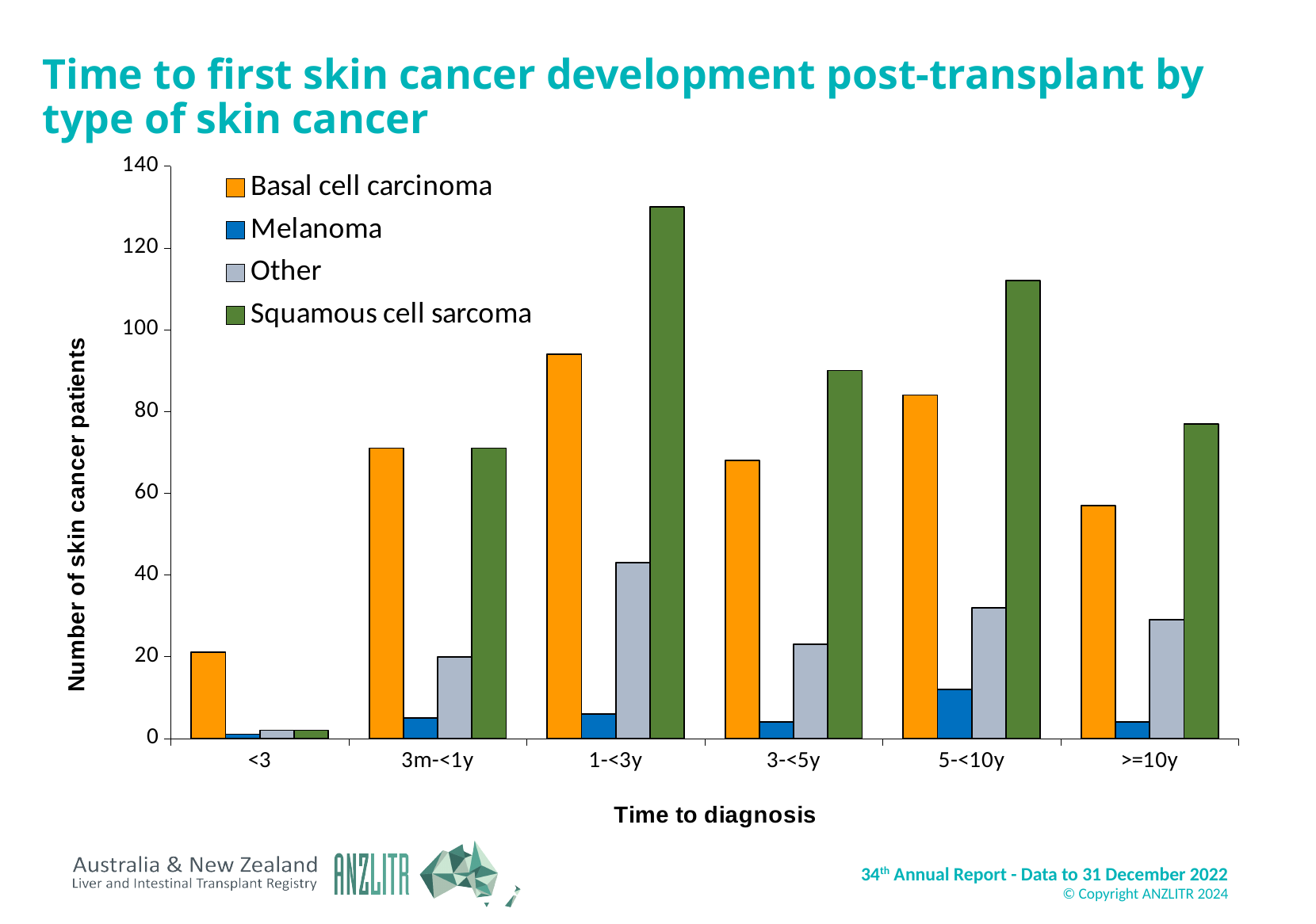
In which time-to-diagnosis category is the Melanoma value highest? 5-<10y Is the Squamous cell sarcoma value for 1-<3y greater or less than 120? greater How many series does the legend list? 4 What kind of chart is shown on the slide? bar chart For the 3-<5y category, which is larger: Basal cell carcinoma or Squamous cell sarcoma? Squamous cell sarcoma In which time-to-diagnosis category is the Squamous cell sarcoma value lowest? <3 In which time-to-diagnosis category is the Basal cell carcinoma value highest? 1-<3y Is the Melanoma value for 5-<10y greater or less than 20? less In which time-to-diagnosis category is the Squamous cell sarcoma value highest? 1-<3y Is the Squamous cell sarcoma value for 5-<10y greater or less than 100? greater Does the Squamous cell sarcoma value rise or fall from <3 to 1-<3y? rise How many time-to-diagnosis categories are shown on the x axis? 6